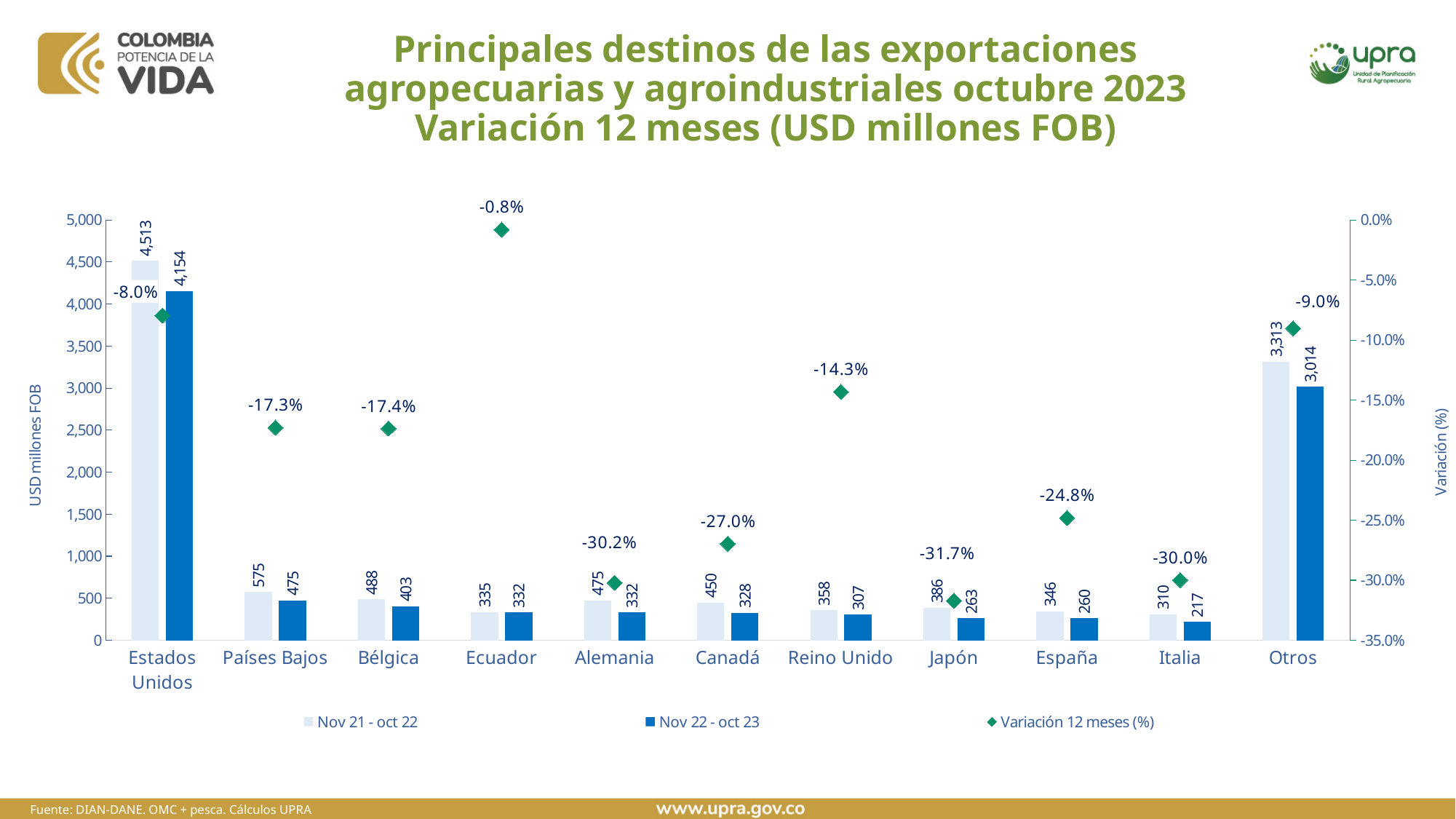
What is the Variación 12 meses (%) value shown for Ecuador? -0.8% What is the value for Japón in the Nov 21 - oct 22 series? 386 How many series does the legend list? 3 How many categories are shown on the x axis? 11 Which is larger: the Nov 22 - oct 23 value for Países Bajos or for Bélgica? Países Bajos What kind of chart is this? Bar chart with a line/marker series for variation What is the value for Estados Unidos in the Nov 22 - oct 23 series? 4,154 Which country has the lowest value in the Nov 22 - oct 23 series? Italia What is the difference between the Nov 21 - oct 22 and Nov 22 - oct 23 values for Alemania? 143 What is the difference between the Nov 21 - oct 22 value for Estados Unidos and its Nov 22 - oct 23 value? 359 Which category has the highest value in the Nov 21 - oct 22 series? Estados Unidos Which country shows the most negative Variación 12 meses (%)? Japón